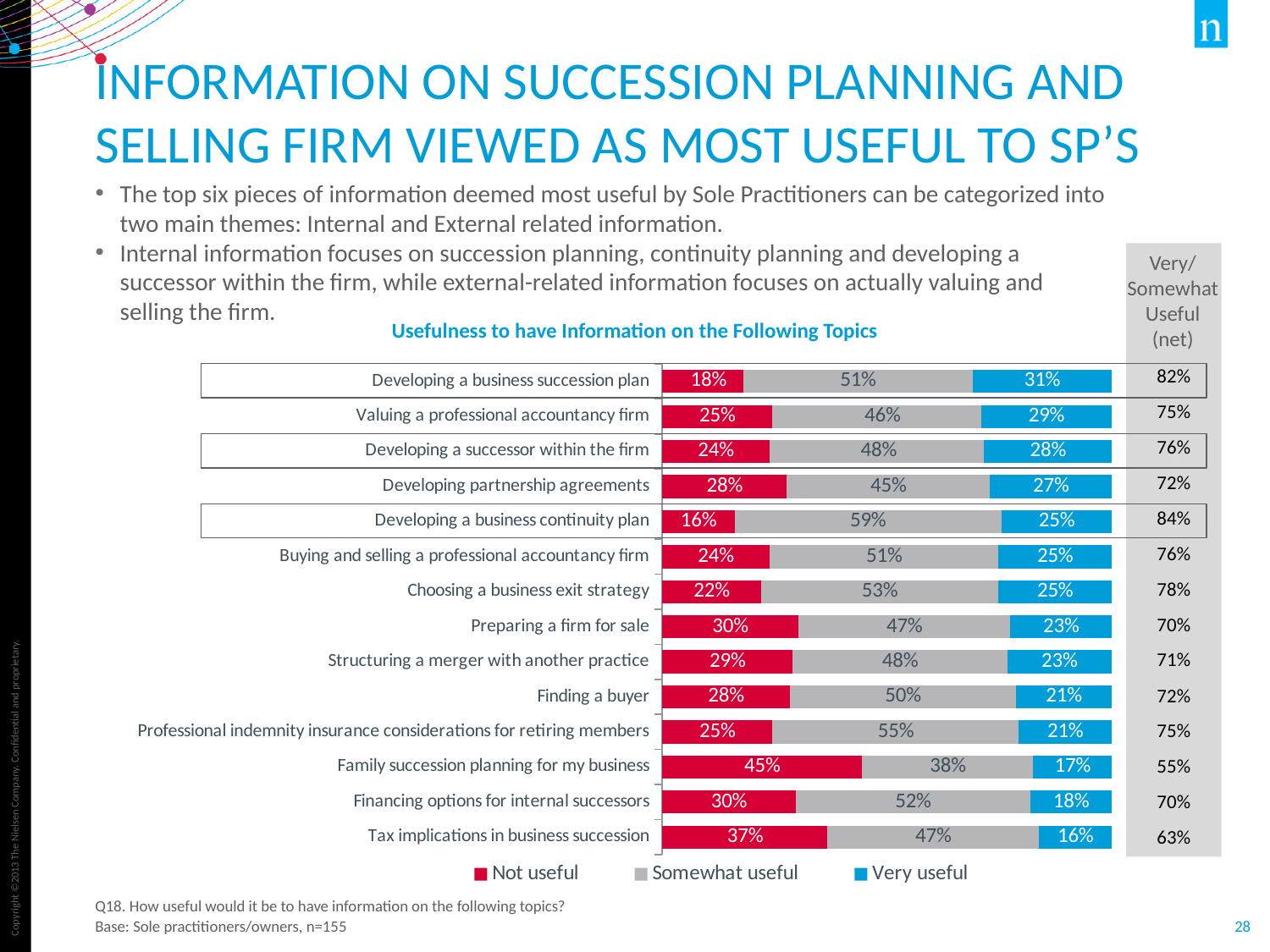
What type of chart is shown on the slide? Stacked bar chart Which topic has the highest 'Very useful' percentage? Developing a business succession plan Which topic has the highest 'Not useful' percentage? Family succession planning for my business What percentage of Sole Practitioners said information on developing a business succession plan would be very useful? 31% What is the 'Not useful' percentage for family succession planning for my business? 45% What is the difference between the 'Not useful' percentages for tax implications in business succession and developing a business continuity plan? 21 percentage points What is the Very/Somewhat Useful (net) value for developing a business continuity plan? 84% What is the 'Somewhat useful' percentage for developing a business continuity plan? 59% Which has a larger 'Very useful' percentage: valuing a professional accountancy firm or finding a buyer? Valuing a professional accountancy firm How many series does the legend list? 3 Which topic has the lowest 'Very useful' percentage? Tax implications in business succession How many topics are listed in the chart? 14